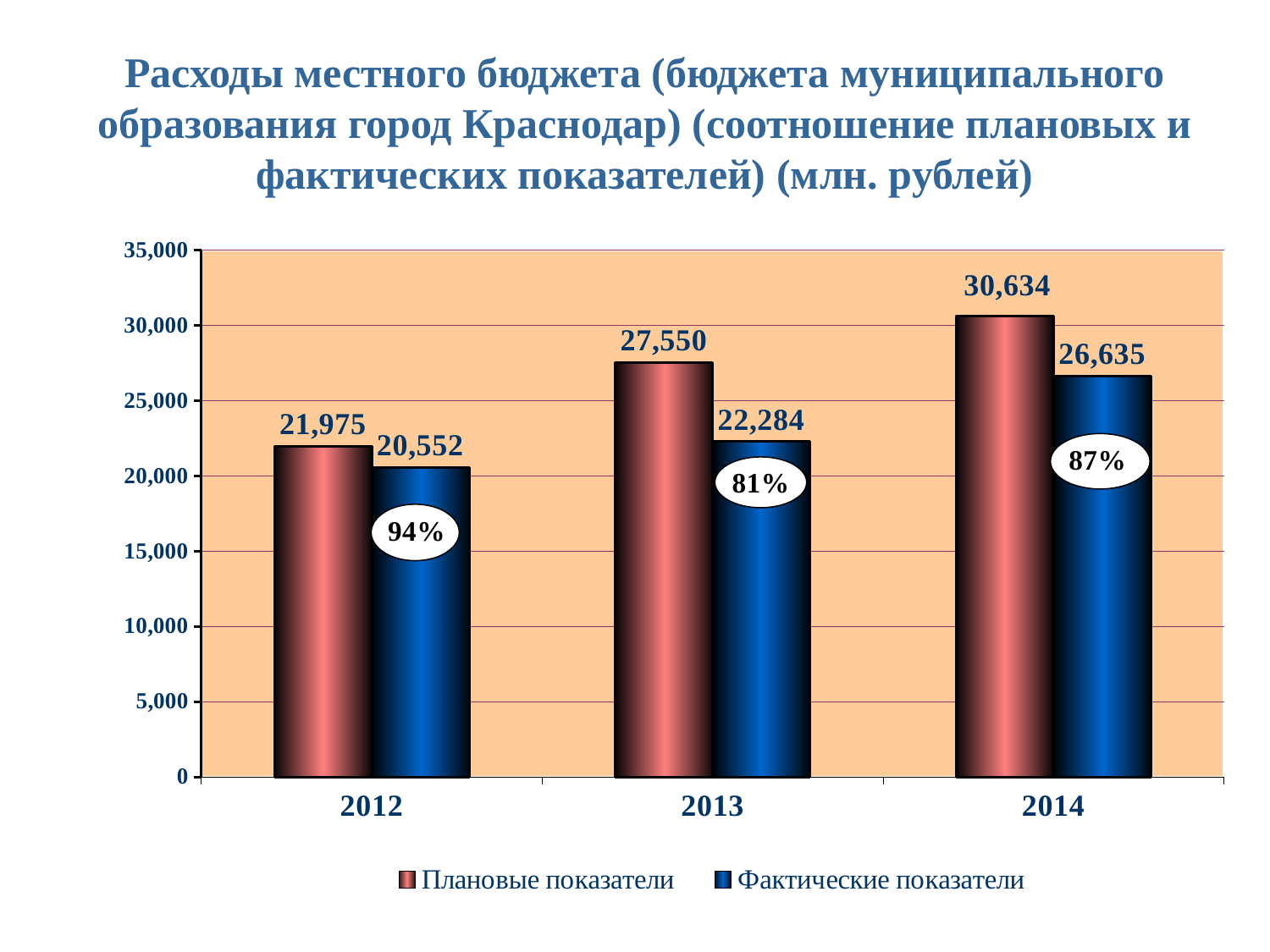
What kind of chart is shown on the slide? bar chart What is the difference between Плановые показатели and Фактические показатели in 2013? 5,266 Which year has the highest value for Плановые показатели? 2014 What percentage is shown in the oval on the 2013 Фактические показатели bar? 81% Which year has the lowest value for Фактические показатели? 2012 How many series does the legend list? 2 Is the value of Фактические показатели for 2014 greater or less than 25,000? greater What is the value of Фактические показатели for 2012? 20,552 How many years are shown on the x axis? 3 What is the value of Фактические показатели for 2013? 22,284 Which is larger in 2014: Плановые показатели or Фактические показатели? Плановые показатели What is the value of Плановые показатели for 2014? 30,634